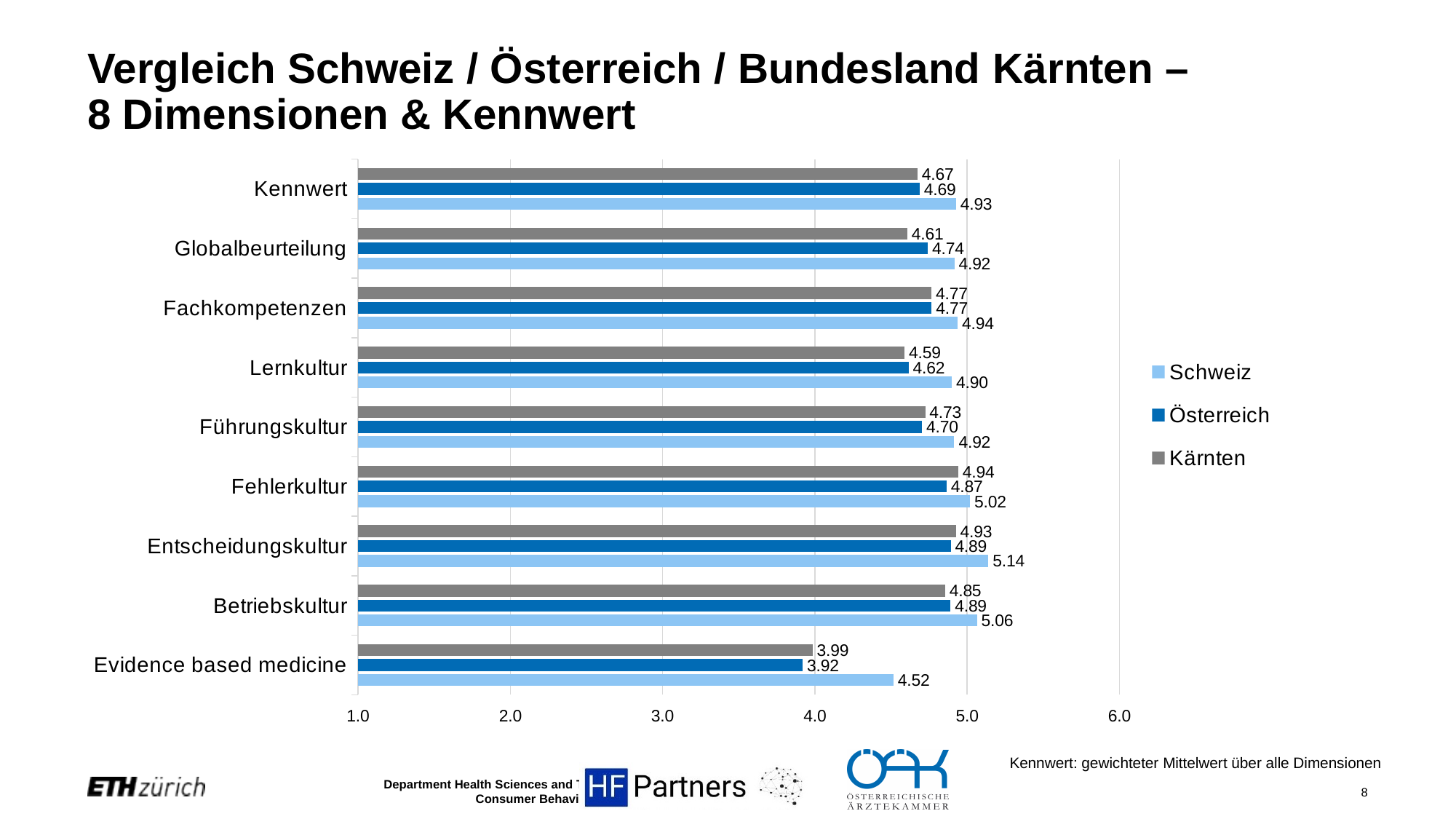
What kind of chart is shown on the slide? Bar chart Which is larger for Fehlerkultur: the Kärnten value or the Österreich value? Kärnten What is the difference between the Schweiz and Kärnten values for Globalbeurteilung? 0.31 What is the difference between the Schweiz and Österreich values for Evidence based medicine? 0.60 How many categories are shown on the y axis of the chart? 9 Which category has the highest value for the Schweiz series? Entscheidungskultur What is the value for Österreich in the Evidence based medicine category? 3.92 Is the value for Schweiz in Betriebskultur greater or less than 5.0? greater Which category has the lowest value for the Kärnten series? Evidence based medicine What is the value for Kärnten in the Kennwert category? 4.67 How many series does the legend list? 3 What is the value for Schweiz in the Entscheidungskultur category? 5.14